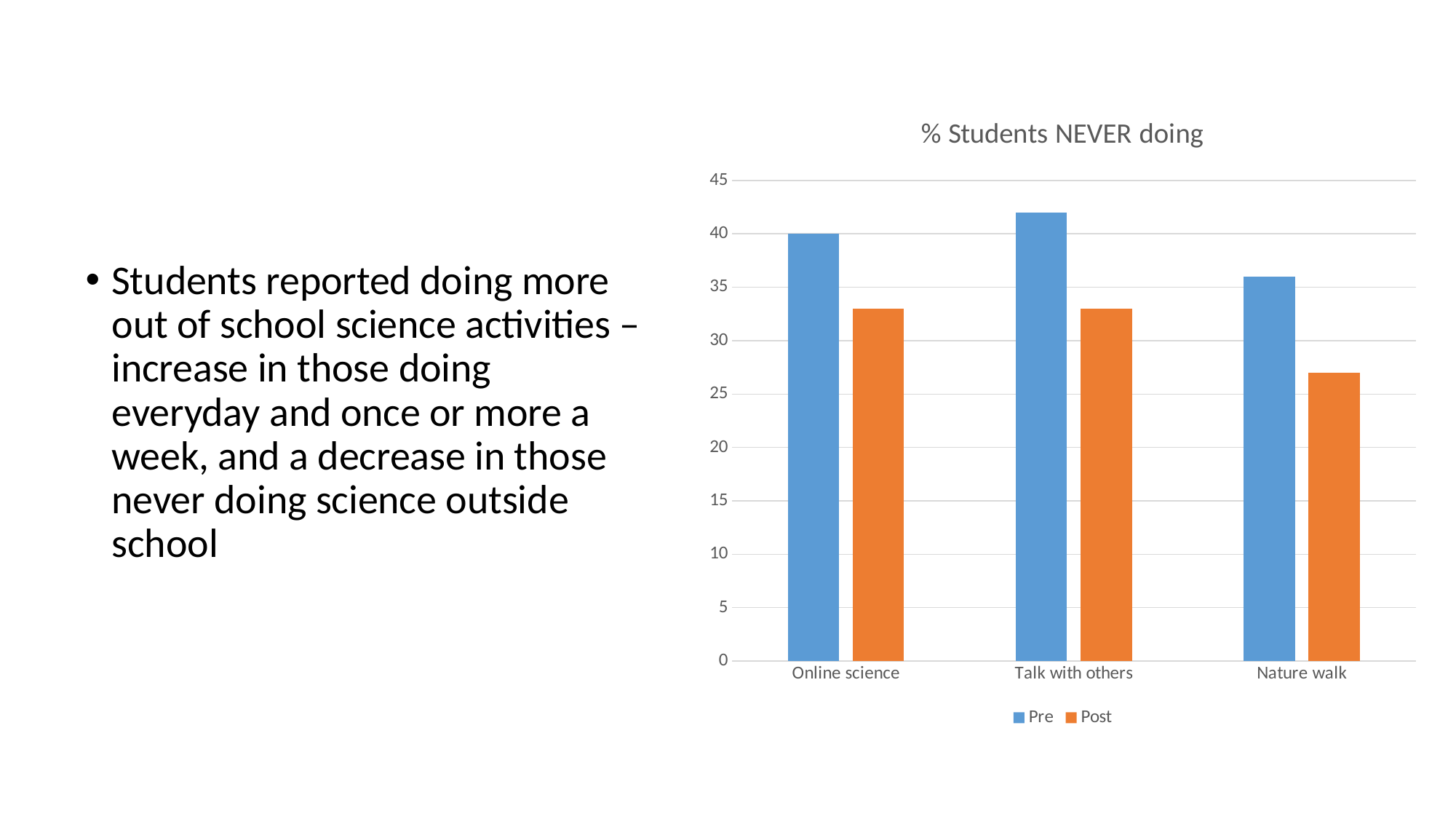
For Nature walk, which is larger, the Pre value or the Post value? Pre Is the Post value for Online science greater or less than 30? greater Which series is shown in orange? Post Is the Post value for Nature walk greater or less than 30? less What type of chart is shown on the slide? bar chart What is the title of the chart? % Students NEVER doing How many categories are shown on the x axis? 3 Which category has the lowest Post value? Nature walk How many series does the legend list? 2 What is the Pre value for Online science? 40 Is the Pre value for Talk with others greater or less than 40? greater Which category has the highest Pre value? Talk with others